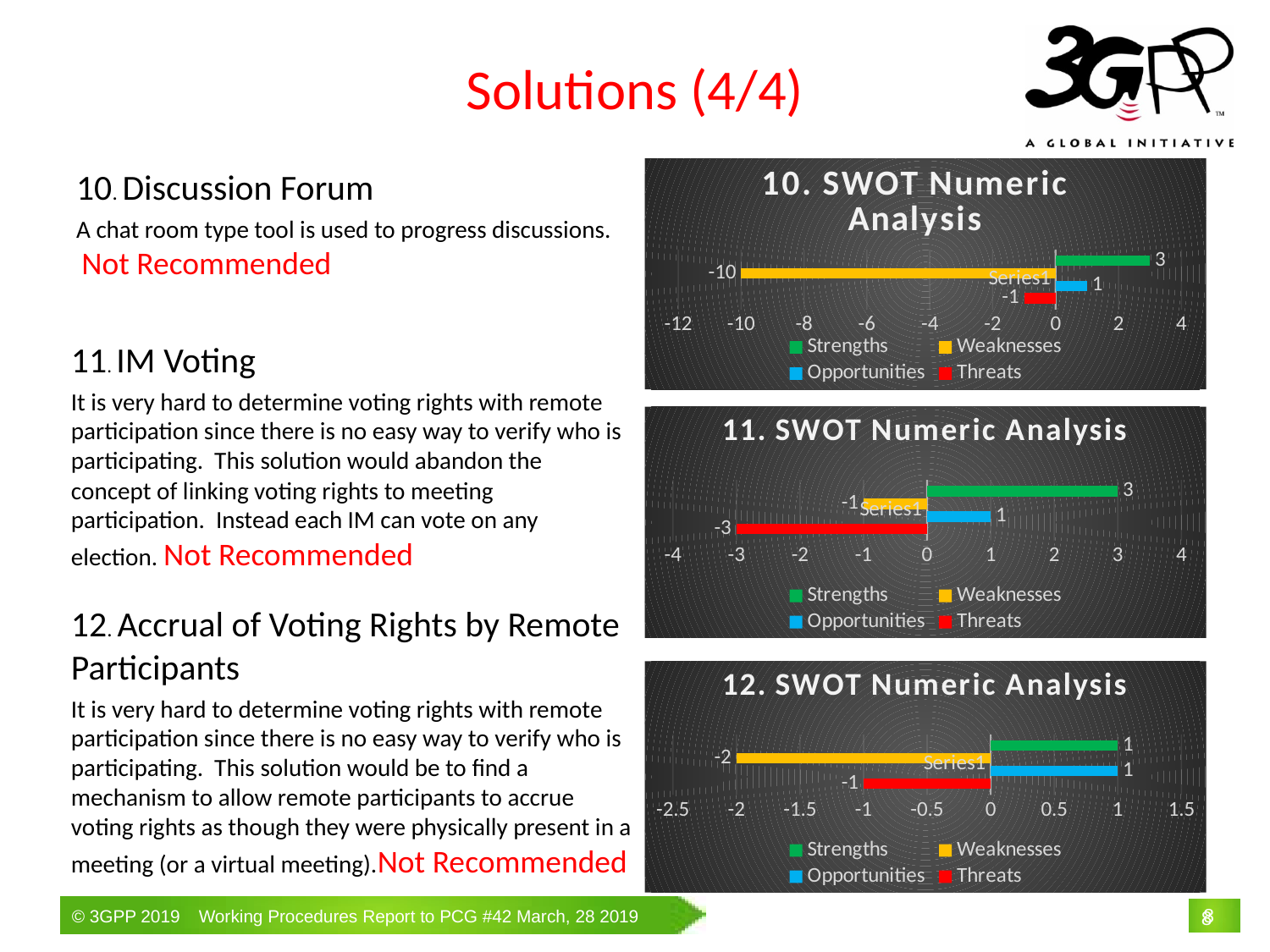
In the chart titled "12. SWOT Numeric Analysis", what is the value for Weaknesses? -2 In the chart titled "11. SWOT Numeric Analysis", which series has the highest value? Strengths In the chart titled "10. SWOT Numeric Analysis", which series has the lowest value? Weaknesses In the chart titled "11. SWOT Numeric Analysis", what is the value for Threats? -3 In the chart titled "10. SWOT Numeric Analysis", what is the value for Weaknesses? -10 In the chart titled "10. SWOT Numeric Analysis", how many series does the legend list? 4 What kind of chart is "12. SWOT Numeric Analysis"? Bar chart In the chart titled "10. SWOT Numeric Analysis", what is the value for Strengths? 3 In the chart titled "12. SWOT Numeric Analysis", what colour is the Opportunities bar? Blue In the chart titled "12. SWOT Numeric Analysis", which is larger, the Weaknesses value or the Threats value? Threats In the chart titled "11. SWOT Numeric Analysis", what is the value for Weaknesses? -1 In the chart titled "11. SWOT Numeric Analysis", what is the difference between the Strengths value and the Opportunities value? 2